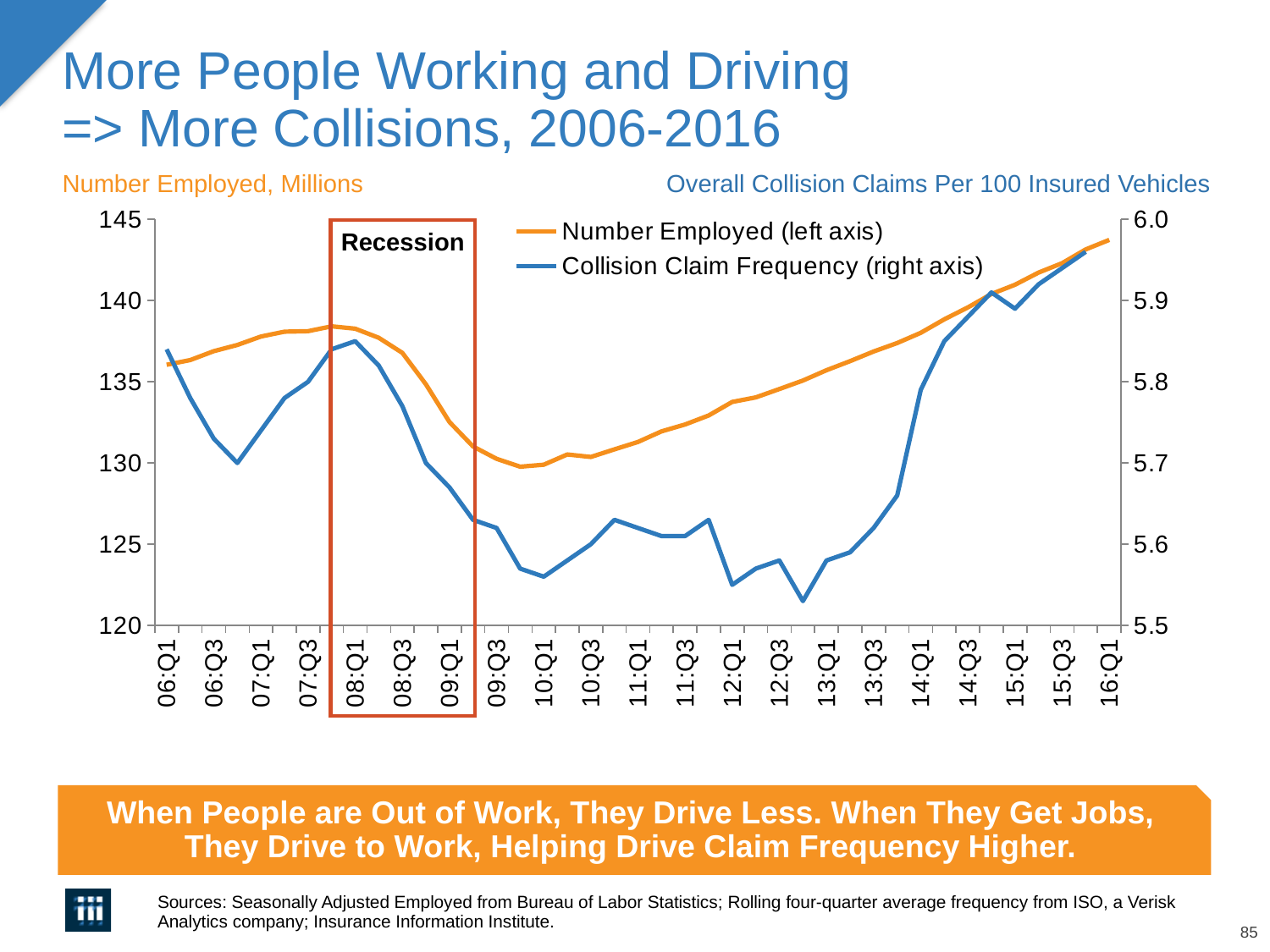
Which series is plotted against the left axis? Number Employed How many series does the chart legend list? 2 Is the value for Collision Claim Frequency at 12:Q3 greater or less than 5.6? less Does Collision Claim Frequency rise or fall from 08:Q1 to 09:Q3? Fall Is the value for Collision Claim Frequency at 10:Q1 greater or less than 5.6? less What kind of chart is shown on the slide? Line chart What is the label of the left vertical axis? Number Employed, Millions Is the value for Number Employed at 16:Q1 greater or less than 140? greater Does Number Employed rise or fall from 10:Q1 to 16:Q1? Rise At which quarter does Number Employed reach its highest value? 16:Q1